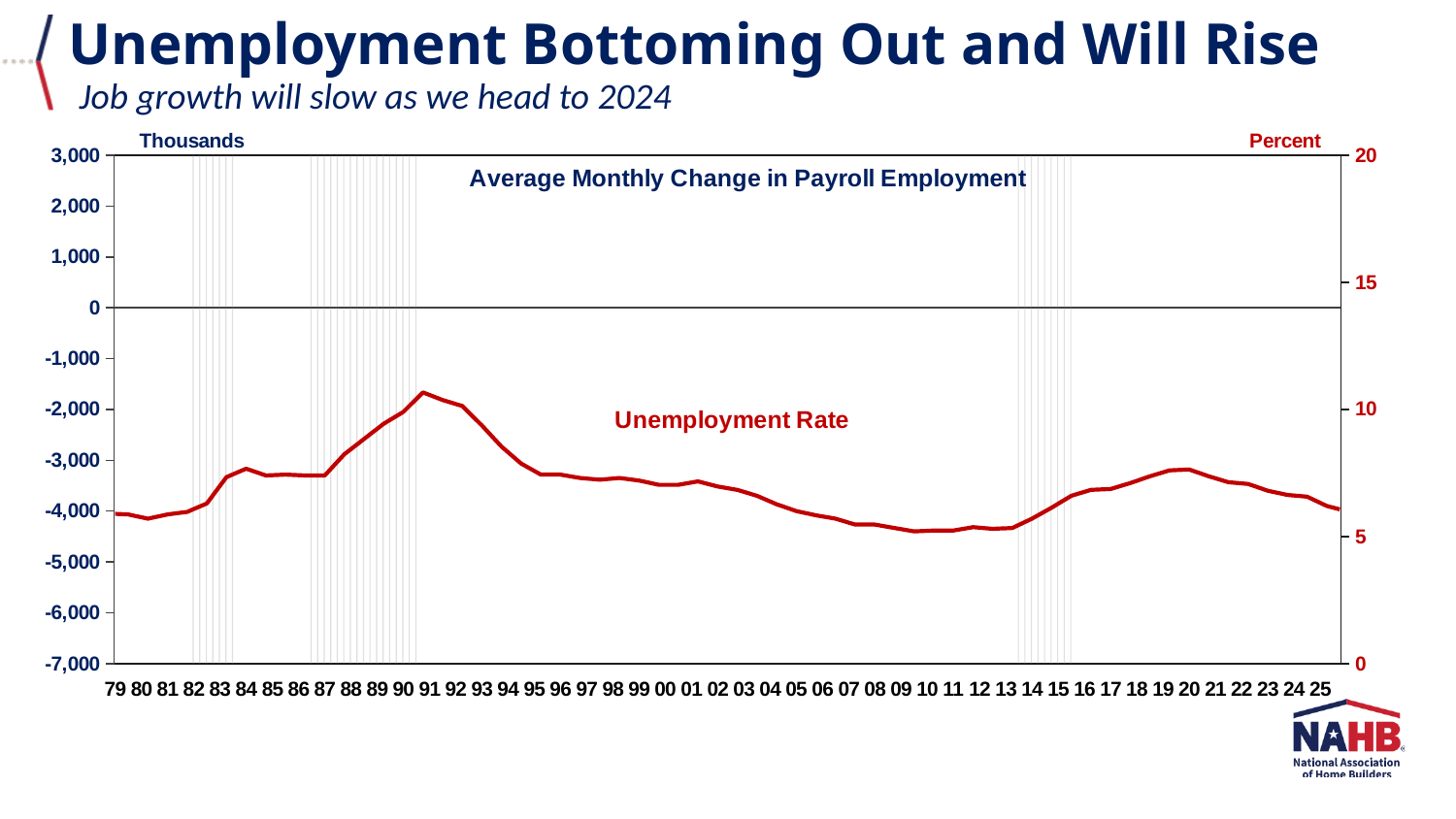
Does the Unemployment Rate line rise or fall between 13 and 20? rise Is the Unemployment Rate in 91 greater or less than 5? greater Is the Unemployment Rate in 20 greater or less than 10? less Is the Unemployment Rate in 10 greater or less than 10? less What unit is shown on the right-hand axis of the chart? Percent Does the Unemployment Rate line rise or fall between 91 and 10? fall What kind of chart is shown on the slide? line chart What is the title of the slide? Unemployment Bottoming Out and Will Rise Which year has the higher Unemployment Rate, 91 or 20? 91 Which year has the higher Unemployment Rate, 10 or 20? 20 In which year does the Unemployment Rate line reach its highest point? 91